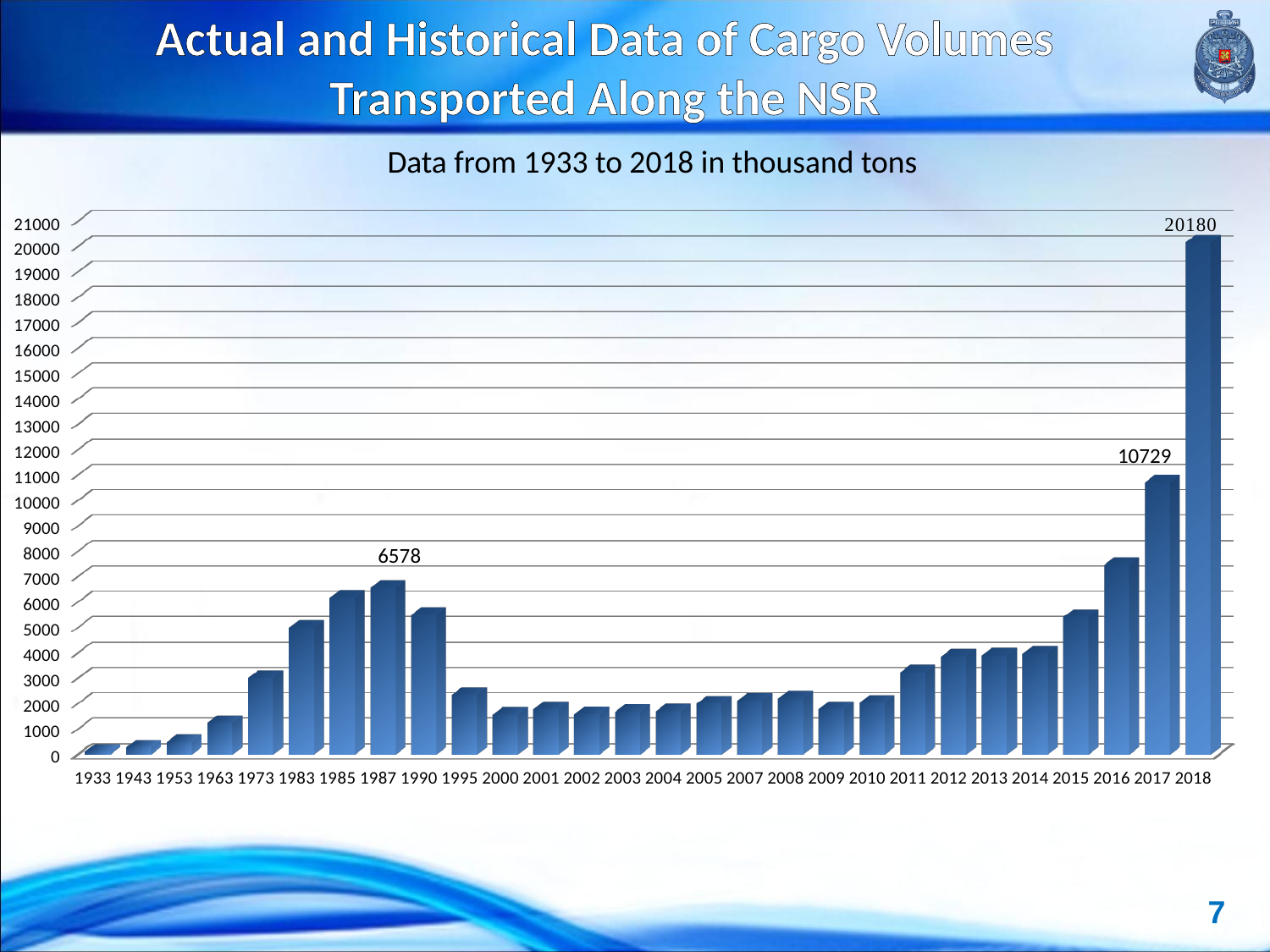
How many years are shown on the x axis? 28 Is the value for 2016 greater or less than 5000? greater Which year has the larger cargo volume, 1987 or 2016? 2016 What is the difference between the cargo volumes for 2018 and 2017? 9451 Which year has the highest cargo volume? 2018 What kind of chart is shown on the slide? Bar chart Which year has the lowest cargo volume? 1933 What is the cargo volume shown for 1987? 6578 Is the value for 1995 greater or less than 3000? less What is the cargo volume shown for 2018? 20180 What is the cargo volume shown for 2017? 10729 What is the difference between the cargo volumes for 2017 and 1987? 4151